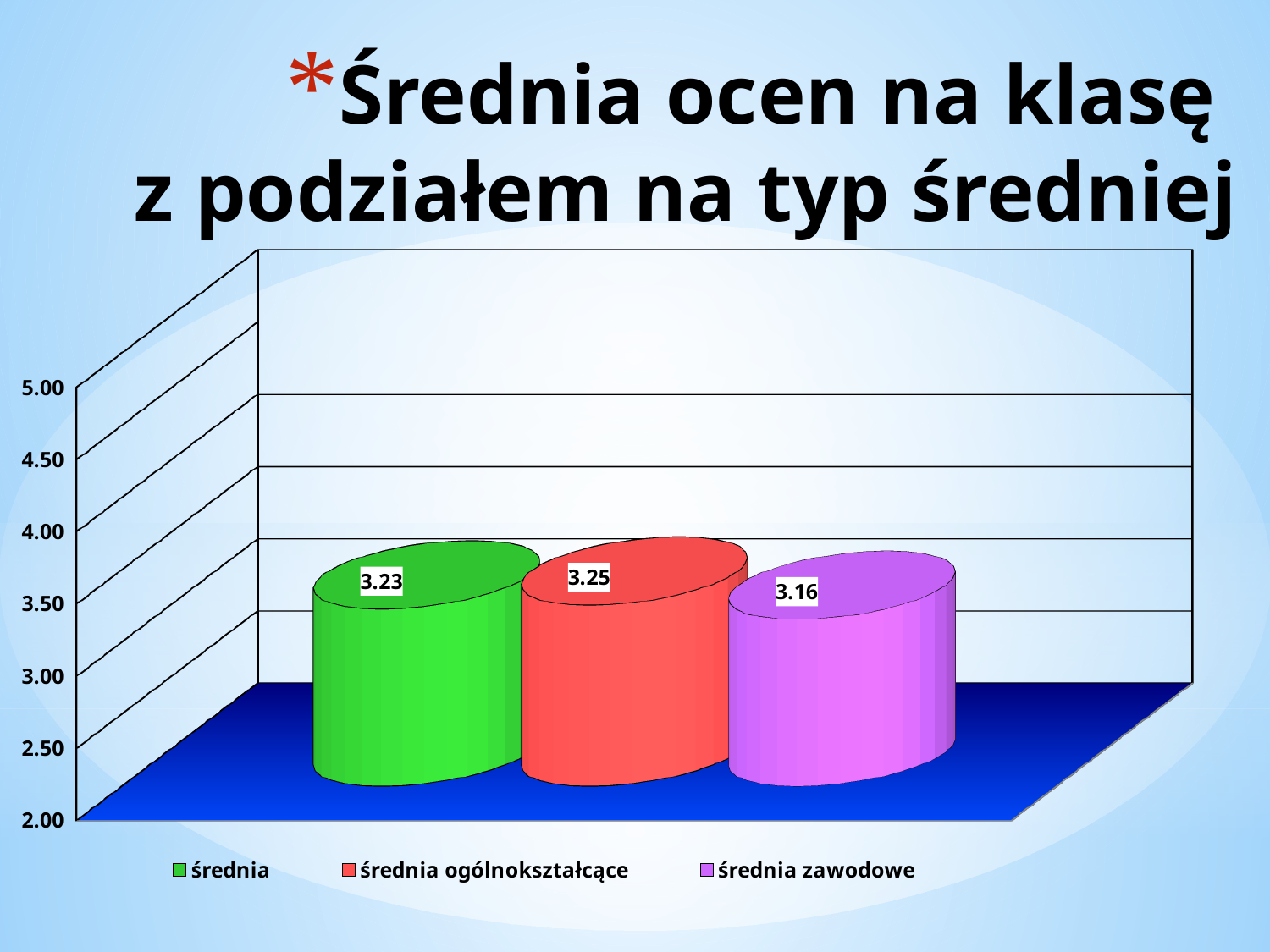
What is the value for średnia zawodowe? 3.16 Is the value for średnia ogólnokształcące greater or less than 3.00? greater What is the difference between the values for średnia ogólnokształcące and średnia zawodowe? 0.09 Which is larger, the value for średnia or the value for średnia zawodowe? średnia What colour is the bar for średnia zawodowe? purple How many series does the legend list? 3 Which series has the highest value? średnia ogólnokształcące What is the value for średnia ogólnokształcące? 3.25 What is the difference between the values for średnia and średnia zawodowe? 0.07 What is the value for średnia? 3.23 What kind of chart is shown on the slide? bar chart Which series has the lowest value? średnia zawodowe